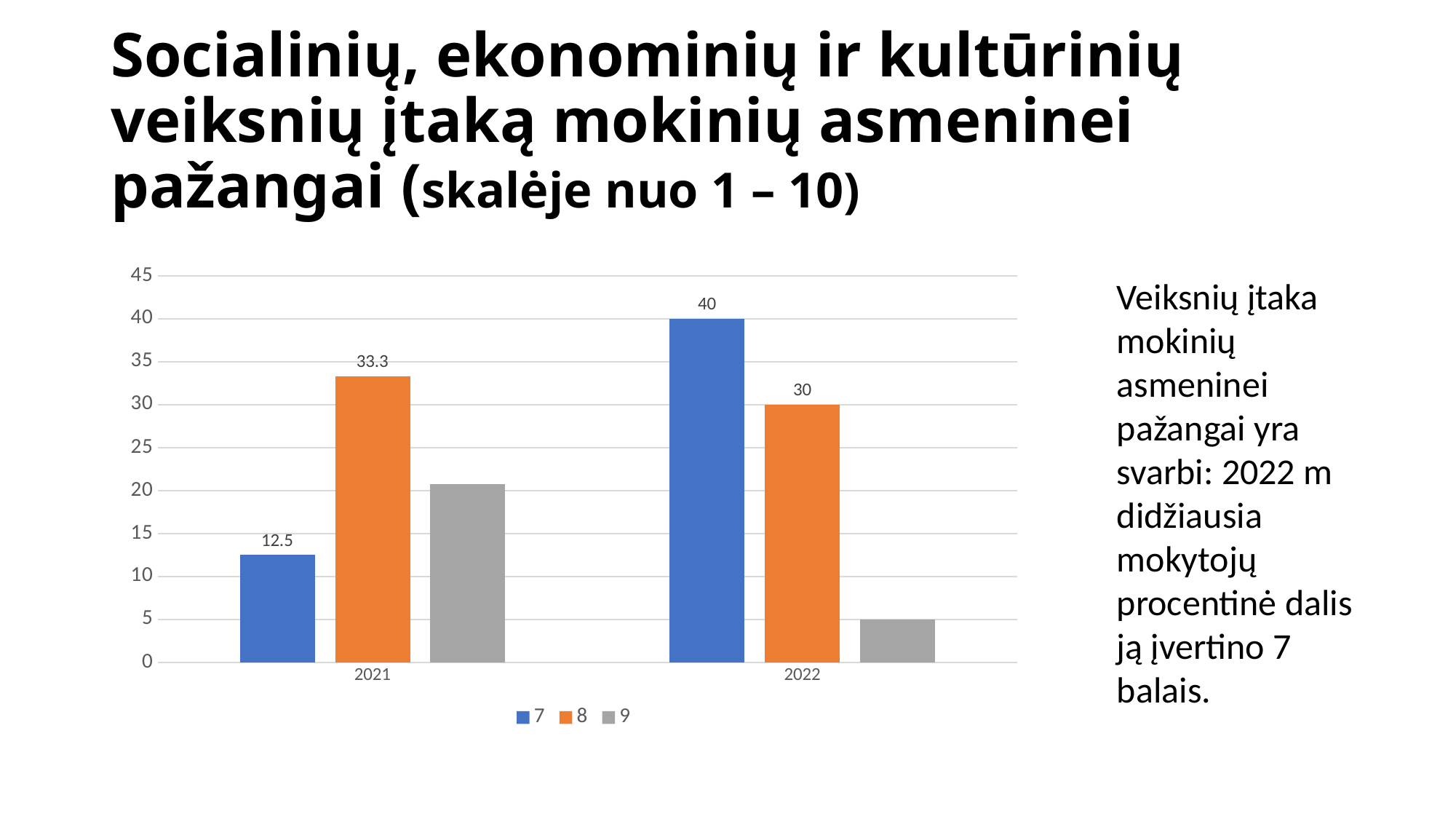
Which series has the highest value in 2022? 7 What is the value for series 8 in 2021? 33.3 What is the value for series 7 in 2021? 12.5 What kind of chart is shown on the slide? bar chart What is the difference between the values for series 7 and series 8 in 2022? 10 Which series has the lowest value in 2022? 9 What is the value for series 7 in 2022? 40 What is the value for series 8 in 2022? 30 How many series does the legend list? 3 Is the value for series 9 in 2022 greater or less than 10? less Does the value for series 7 rise or fall from 2021 to 2022? rise Which is larger in 2021: the value for series 7 or series 8? 8